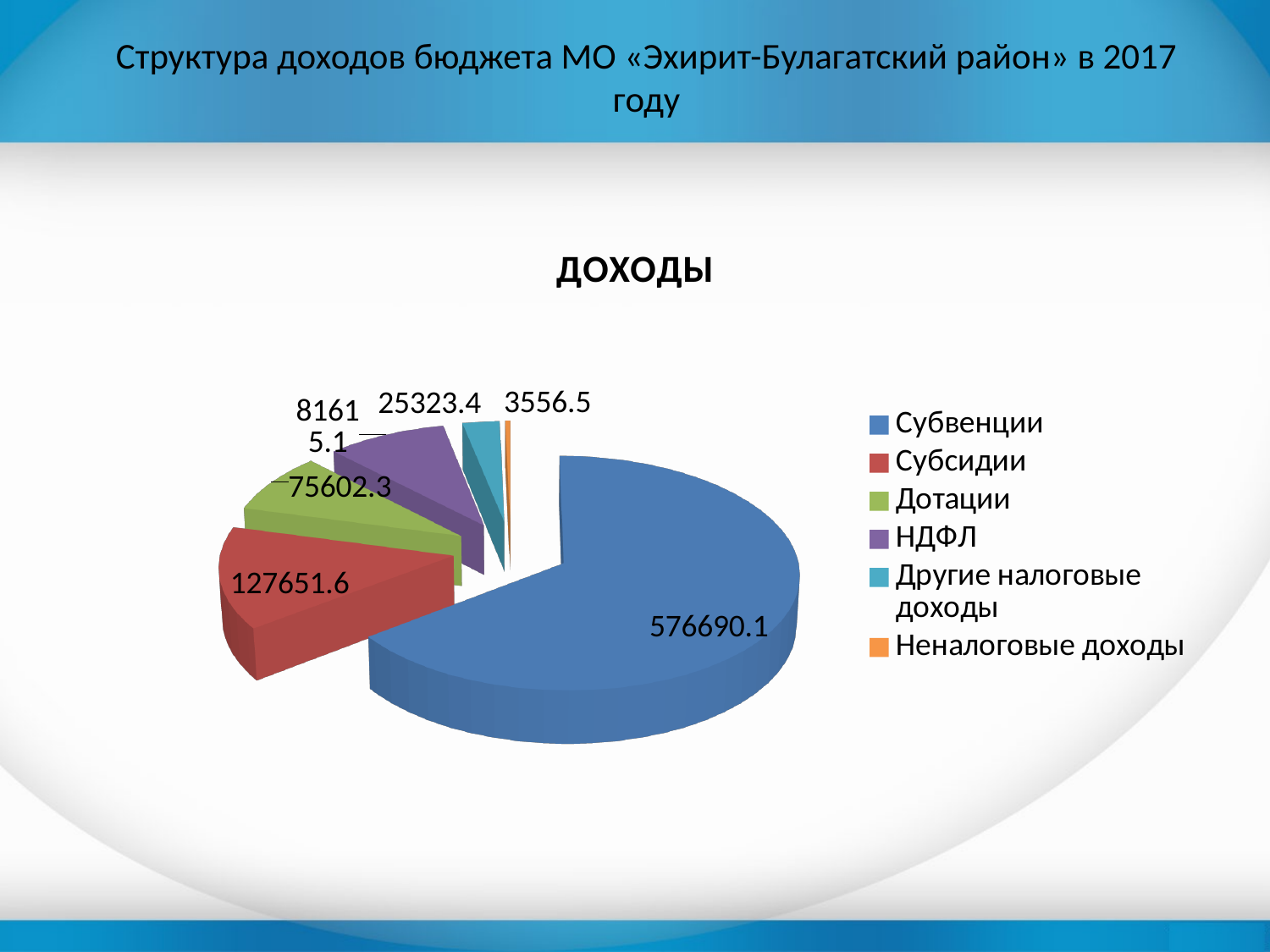
How many entries does the legend list? 6 What is the title of the chart? ДОХОДЫ What kind of chart is shown on the slide? Pie chart What is the value for Дотации? 75602.3 What is the value for Субвенции? 576690.1 What is the value for Неналоговые доходы? 3556.5 Which category has the largest slice? Субвенции Which category has the smallest slice? Неналоговые доходы How many slices does the pie chart have? 6 What is the value for Субсидии? 127651.6 What is the value for Другие налоговые доходы? 25323.4 What is the difference between the values for Субсидии and Дотации? 52049.3